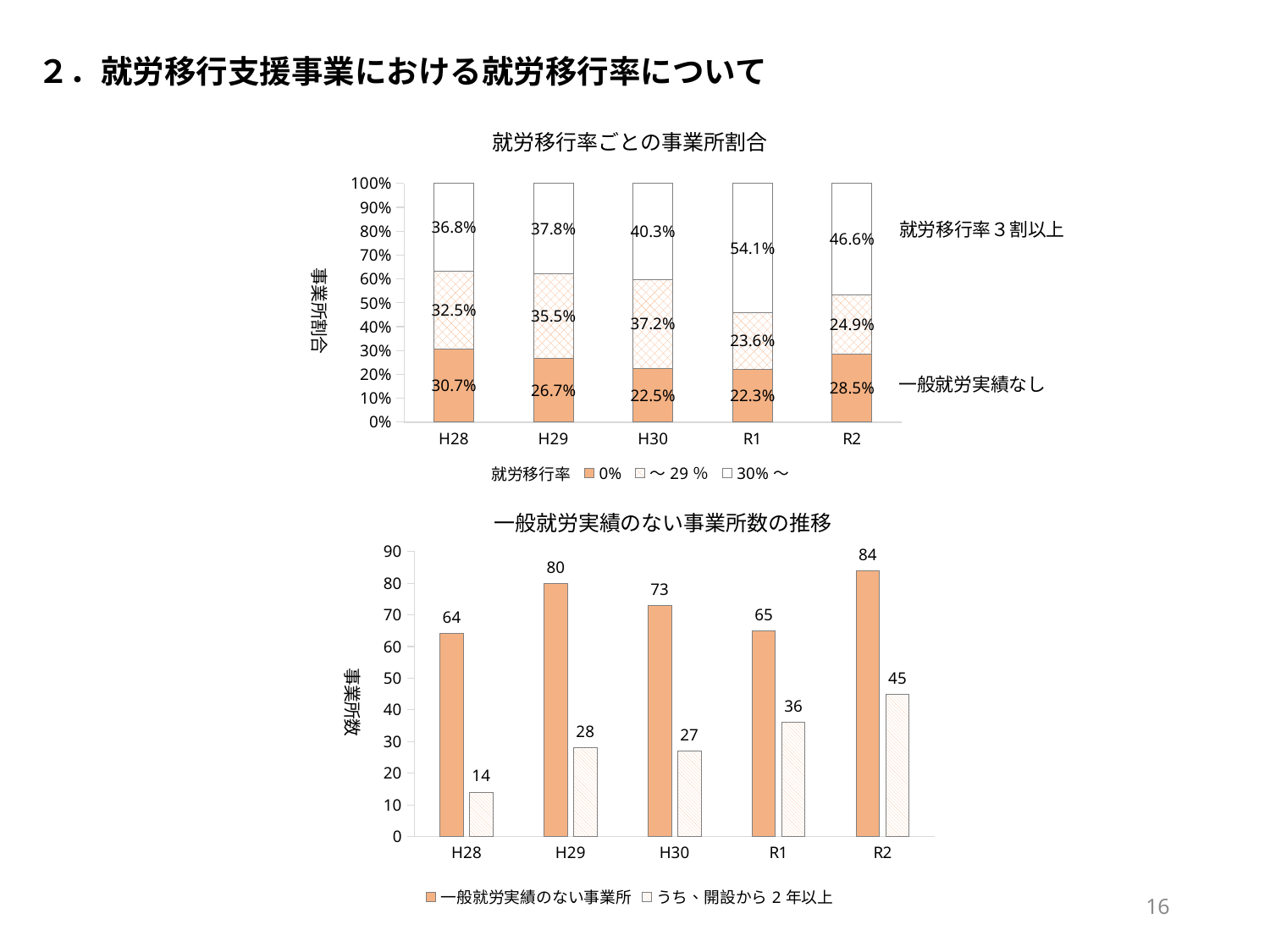
In the chart titled 一般就労実績のない事業所数の推移, what is the value of うち、開設から2年以上 for R2? 45 In the chart titled 就労移行率ごとの事業所割合, how many series does the legend list? 3 In the chart titled 一般就労実績のない事業所数の推移, what is the difference between the 一般就労実績のない事業所 value and the うち、開設から2年以上 value for R1? 29 In the chart titled 一般就労実績のない事業所数の推移, which category has the lowest value for うち、開設から2年以上? H28 In the chart titled 就労移行率ごとの事業所割合, what is the value of the 0% series for H28? 30.7% In the chart titled 就労移行率ごとの事業所割合, what is the value of the 30%～ series for R1? 54.1% In the chart titled 就労移行率ごとの事業所割合, which category has the highest value for the 30%～ series? R1 In the chart titled 一般就労実績のない事業所数の推移, which category has the highest value for 一般就労実績のない事業所? R2 What kind of chart is the one titled 一般就労実績のない事業所数の推移? Bar chart In the chart titled 就労移行率ごとの事業所割合, what is the difference between the ～29% values for H30 and R1? 13.6% In the chart titled 就労移行率ごとの事業所割合, which category has the lowest value for the 0% series? R1 In the chart titled 一般就労実績のない事業所数の推移, what is the value of 一般就労実績のない事業所 for H29? 80